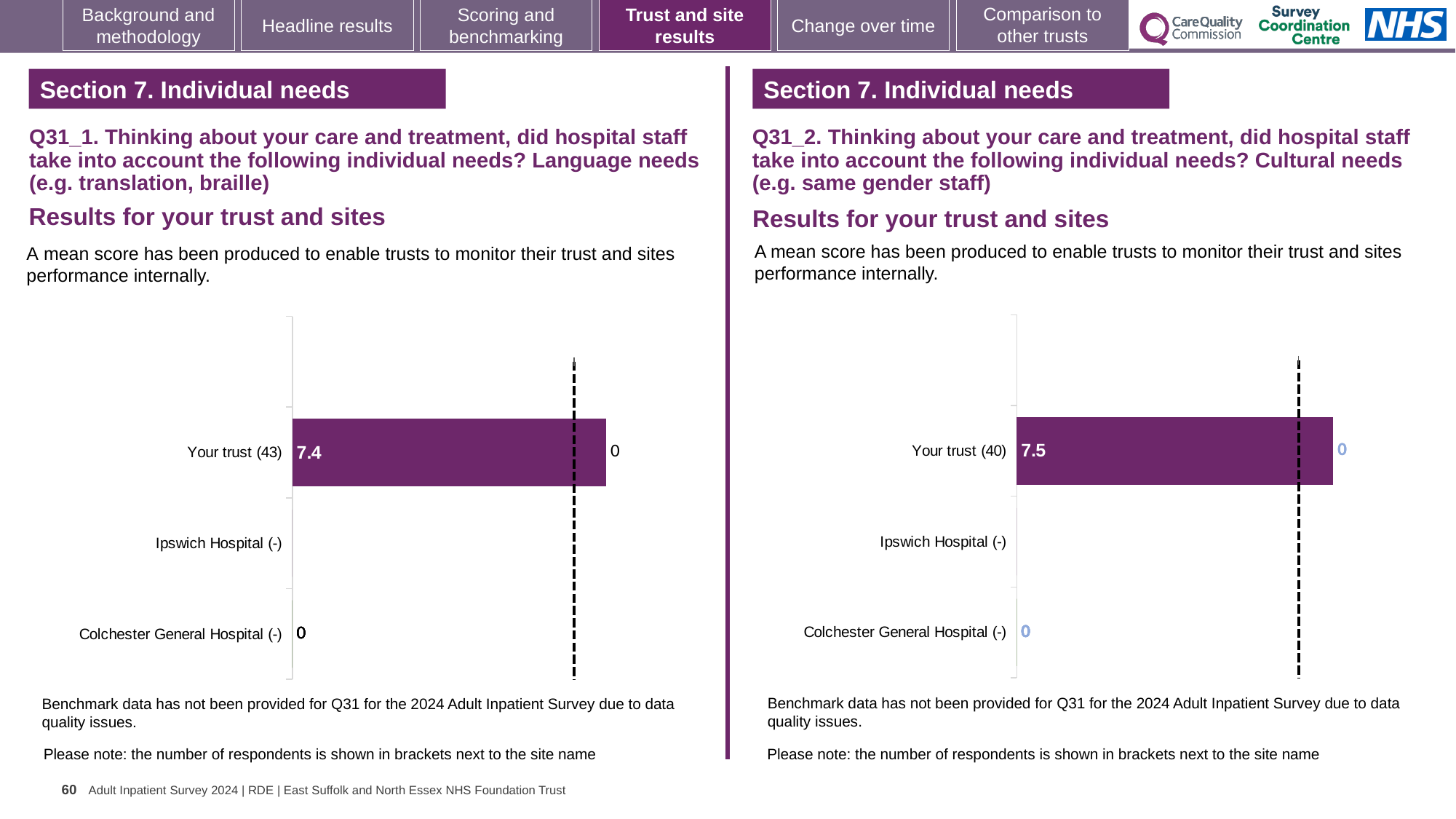
In the right chart (Q31_2), how many respondents are shown in brackets next to Your trust? 40 How many categories are listed on the vertical axis of the left chart (Q31_1)? 3 In the left chart (Q31_1), which category has the highest mean score? Your trust (43) In the left chart (Q31_1), how many respondents are shown in brackets next to Your trust? 43 In the left chart (Q31_1, Language needs), what is the mean score for Your trust? 7.4 What type of chart is used in the left chart (Q31_1)? bar chart Which chart shows a higher mean score for Your trust: the left chart (Language needs) or the right chart (Cultural needs)? the right chart (Cultural needs) How many categories are listed on the vertical axis of the right chart (Q31_2)? 3 In the right chart (Q31_2), which category has the highest mean score? Your trust (40) In the right chart (Q31_2, Cultural needs), what is the mean score for Your trust? 7.5 What is the difference between the Your trust mean score in the right chart (Cultural needs) and in the left chart (Language needs)? 0.1